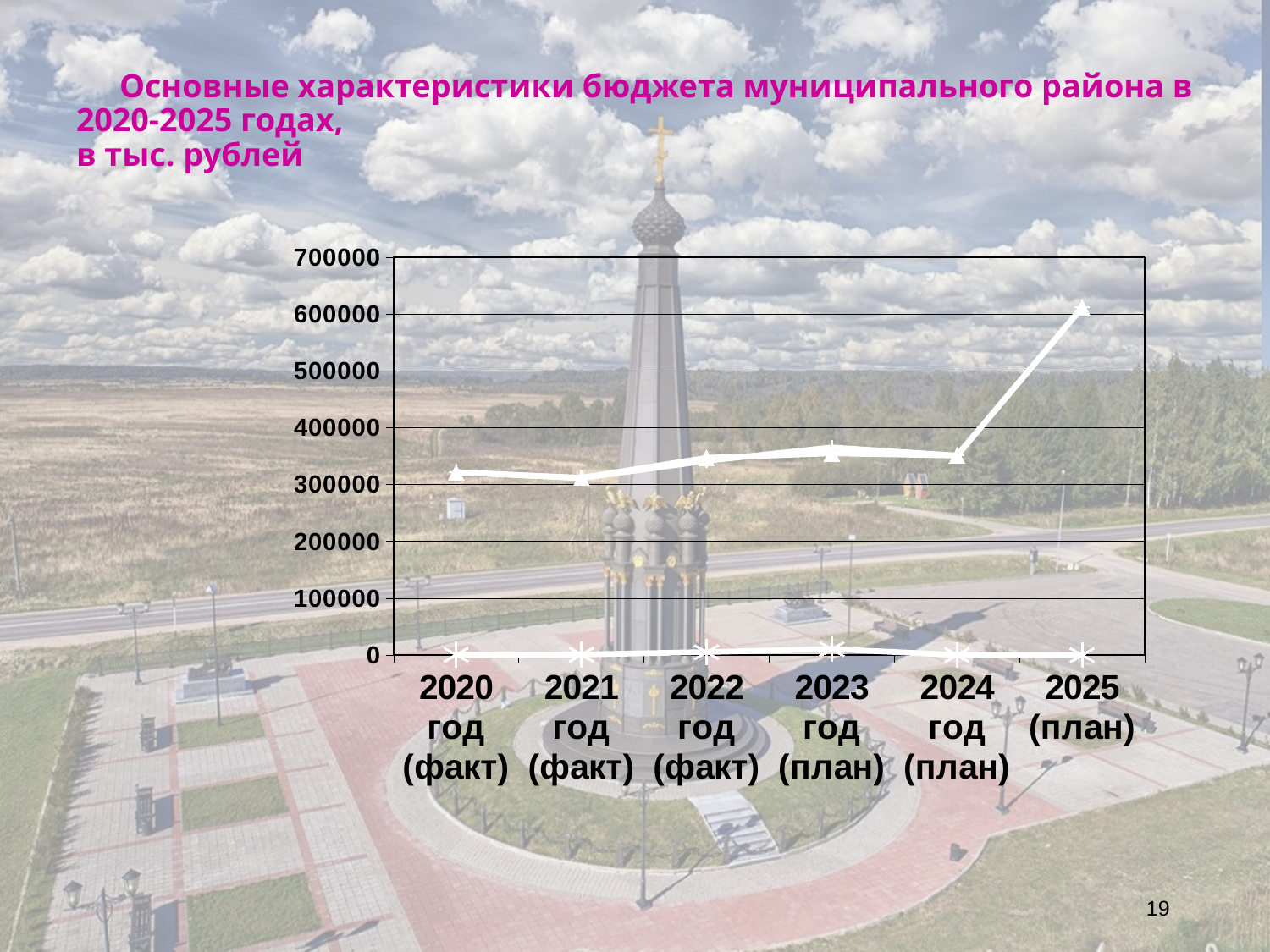
How many categories (years) are shown on the x axis of the chart? 6 Is the value of the upper line for 2025 (план) greater or less than 500000? greater What is the highest value shown on the vertical axis of the chart? 700000 Is the value of the upper line for 2022 год (факт) greater or less than 400000? less Is the value of the lower line (star markers) for 2024 год (план) greater or less than 100000? less Which is larger for the upper line: the value for 2025 (план) or the value for 2020 год (факт)? 2025 (план) How many lines are plotted on the chart? 3 In which year does the upper line (triangle markers) reach its highest value? 2025 (план) Does the upper line rise or fall between 2024 год (план) and 2025 (план)? rise What kind of chart is shown on the slide? line chart In what units are the budget figures on the slide expressed, according to the title? тыс. рублей